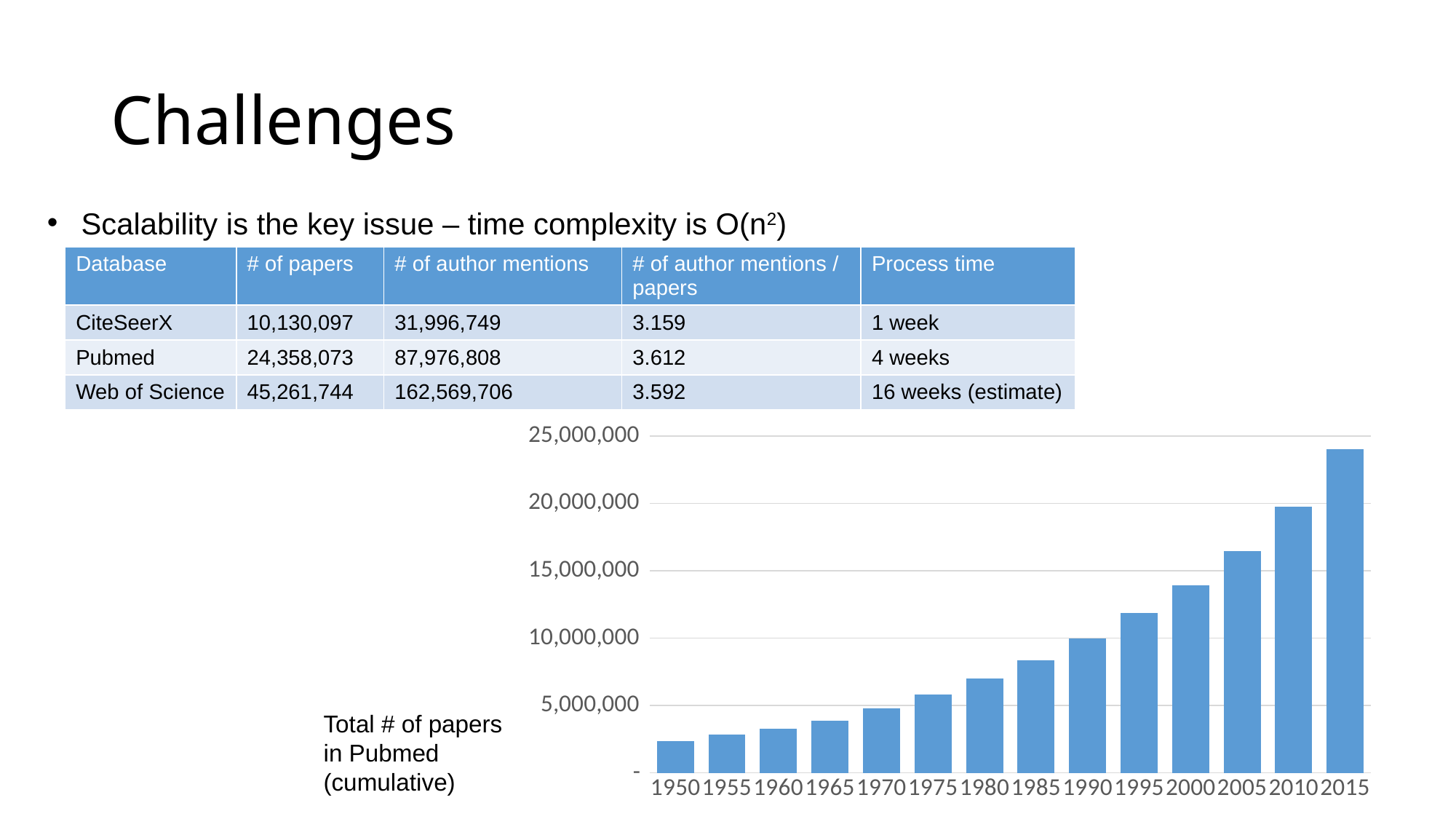
Is the value for 1950 greater or less than 5,000,000? less How many years (bars) are plotted in the chart? 14 What does the chart show, according to the caption next to it? Total # of papers in Pubmed (cumulative) Which year has the highest total number of papers in the chart? 2015 Is the value for 2005 greater or less than 15,000,000? greater Which year has the larger value, 2000 or 2010? 2010 Is the value for 1980 greater or less than 5,000,000? greater What kind of chart is shown on the slide? bar chart Which year has the lowest total number of papers in the chart? 1950 Do the values in the chart rise or fall from 1950 to 2015? rise